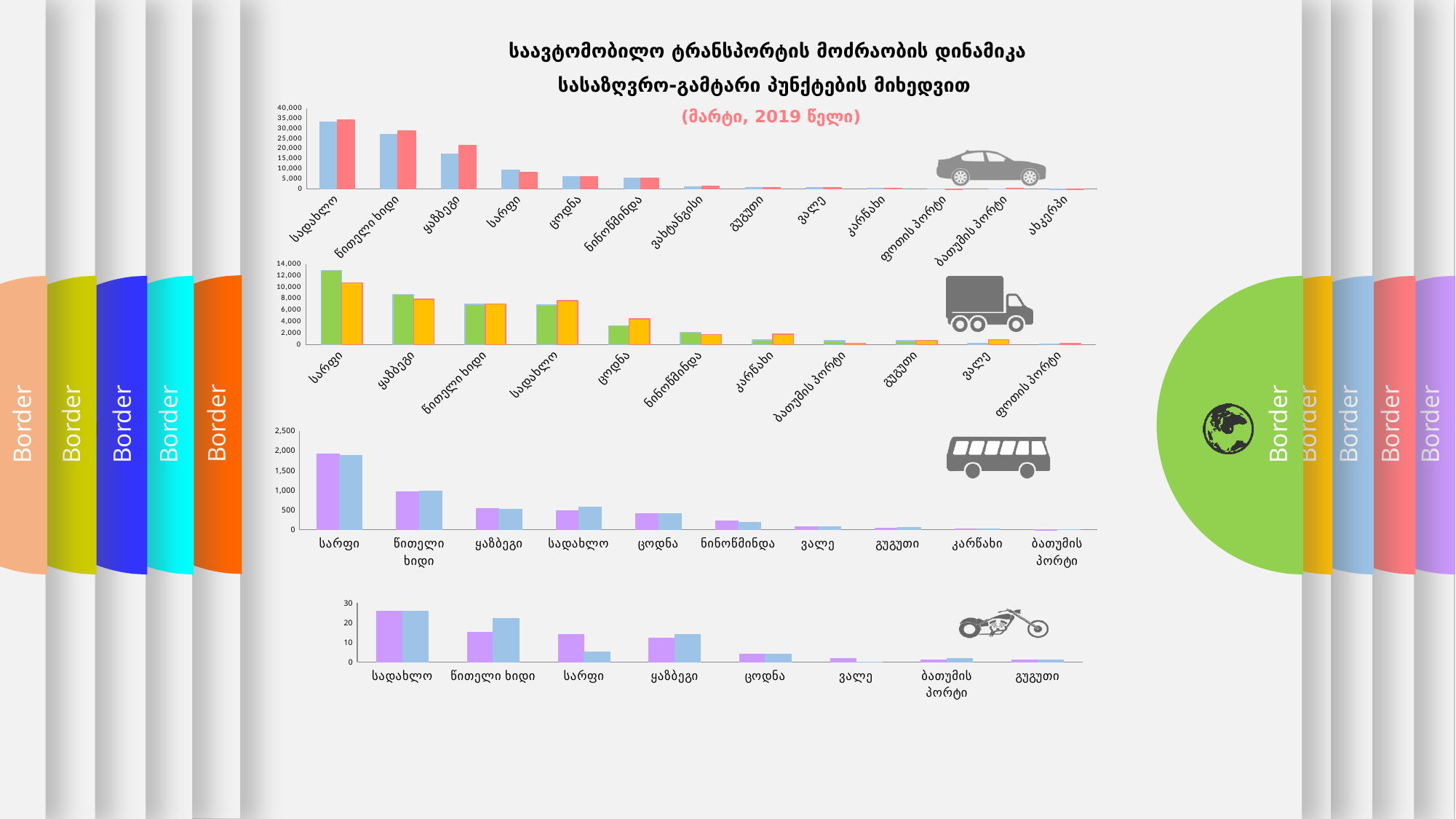
In the second chart from the top (with the truck icon), is the green bar for ყაზბეგი greater or less than 10,000? less How many categories are shown on the x axis of the top chart (with the car icon)? 13 In the bottom chart (with the motorcycle icon), which bar for სარფი is larger, the purple one or the blue one? the purple one In the top chart (with the car icon), is the red bar for სადახლო greater or less than 30,000? greater How many categories are shown on the x axis of the bottom chart (with the motorcycle icon)? 8 In the bottom chart (with the motorcycle icon), is the blue bar for სარფი greater or less than 10? less In the top chart (with the car icon), which category has the highest values? სადახლო What kind of chart is the top chart (with the car icon)? bar chart In the bottom chart (with the motorcycle icon), which category has the highest values? სადახლო In the second chart from the top (with the truck icon), which category has the highest values? სარფი